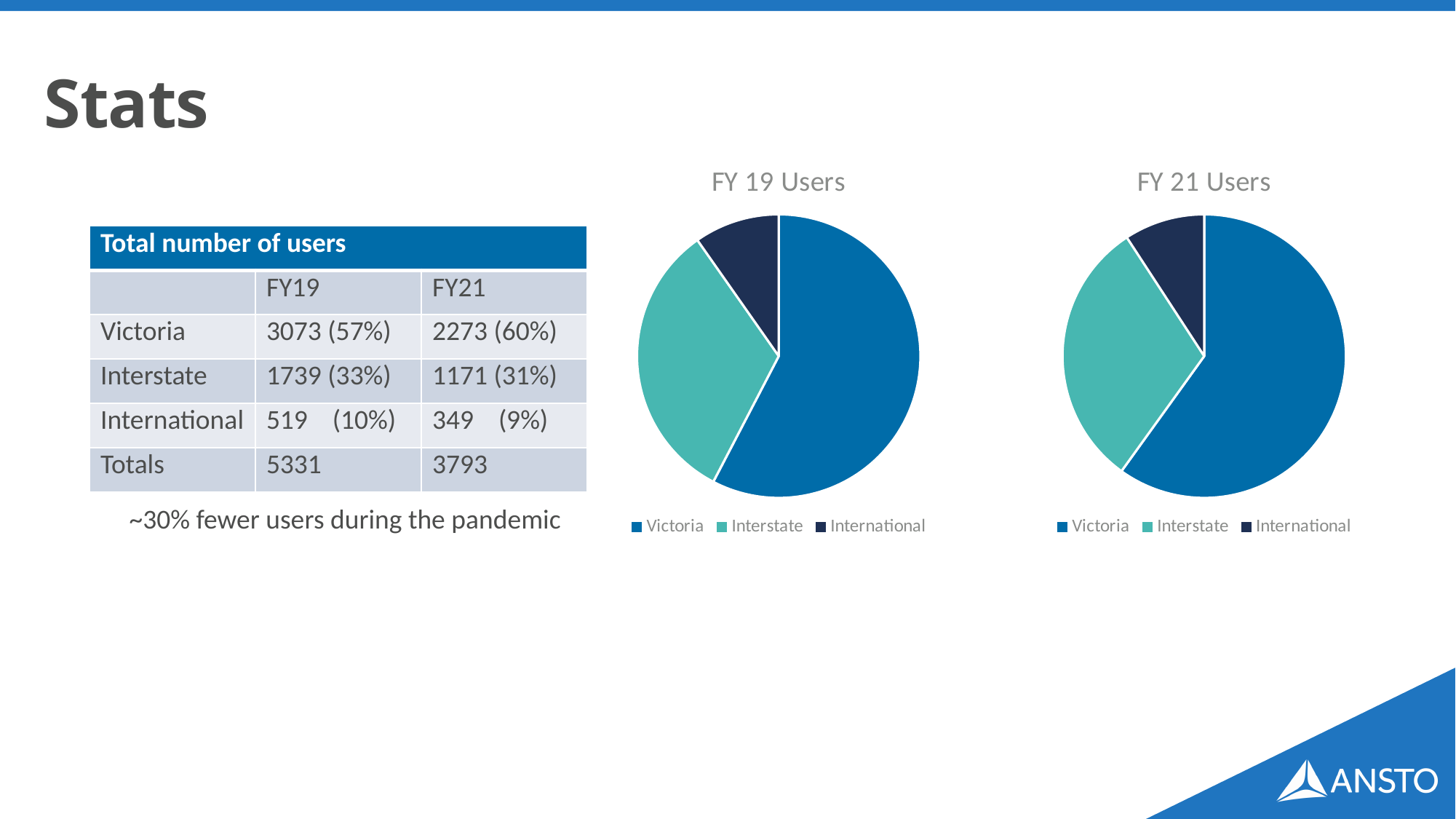
How many slices does the FY 19 Users pie chart have? 3 What kind of chart is the FY 19 Users chart? pie chart In the FY 21 Users chart, which slice is larger, Interstate or International? Interstate What is the title of the pie chart on the right of the slide? FY 21 Users In the FY 21 Users chart, which category has the smallest slice? International In the FY 19 Users chart, which slice is larger, Victoria or Interstate? Victoria How many entries does the legend of the FY 21 Users chart list? 3 In the FY 19 Users chart, which category has the largest slice? Victoria According to the slide, what share of the FY 19 Users pie does Victoria represent? 57% According to the slide, what share of the FY 21 Users pie does Interstate represent? 31% What kind of chart is the FY 21 Users chart? pie chart Which colour represents International in the FY 19 Users chart legend? dark navy blue